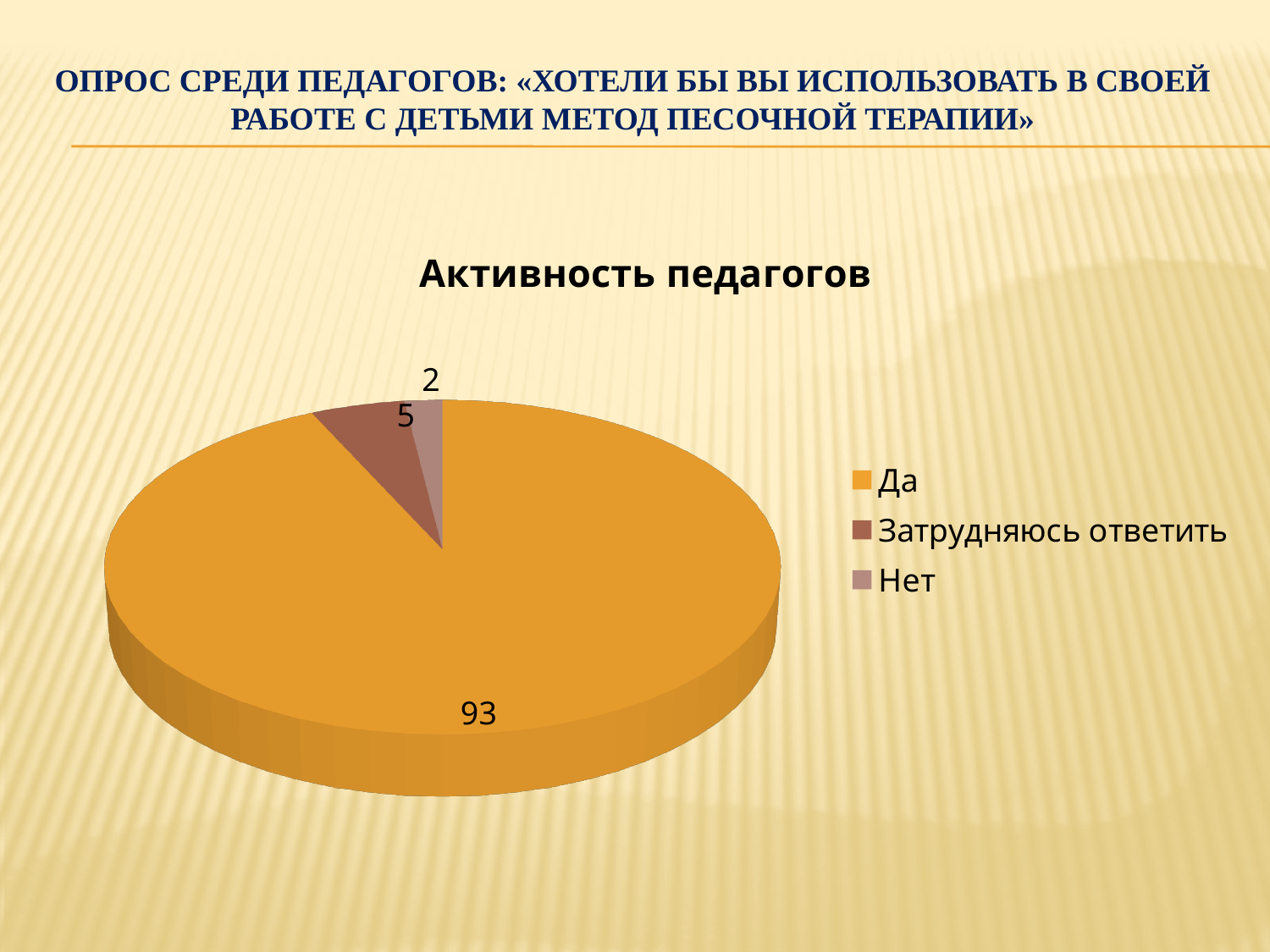
Which category has the smallest slice? Нет What is the value for "Да"? 93 Which is larger, the value for "Затрудняюсь ответить" or the value for "Нет"? Затрудняюсь ответить What type of chart is shown on the slide? Pie chart What is the title of the chart? Активность педагогов What is the value for "Нет"? 2 How many categories does the pie chart have? 3 What is the value for "Затрудняюсь ответить"? 5 What is the difference between the values for "Затрудняюсь ответить" and "Нет"? 3 Which category has the largest slice? Да What is the total of all the slice values in the pie chart? 100 What is the difference between the values for "Да" and "Затрудняюсь ответить"? 88